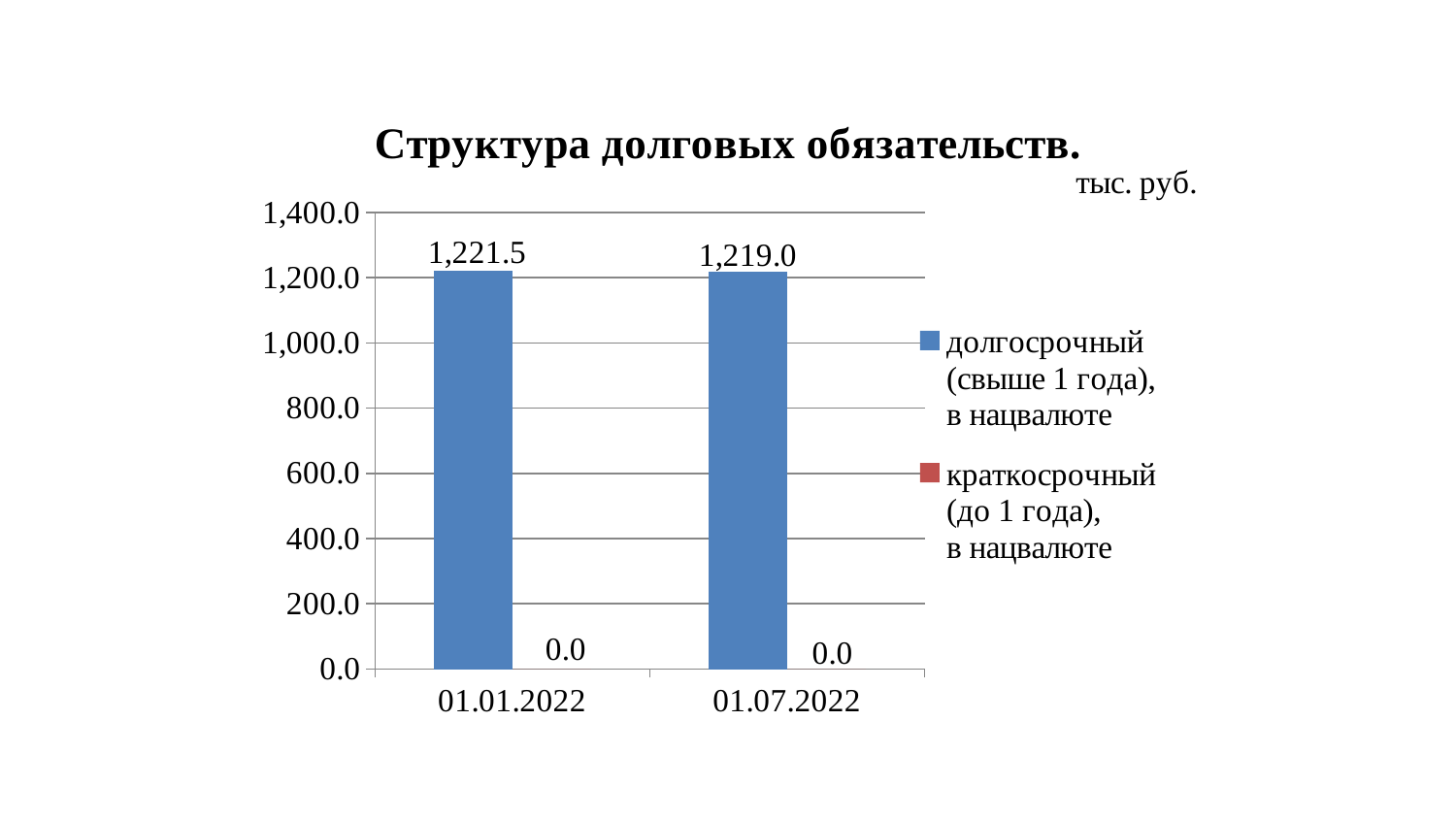
What is the difference between the долгосрочный values for 01.01.2022 and 01.07.2022? 2.5 How many series does the legend list? 2 What is the title of the chart? Структура долговых обязательств. What is the value of краткосрочный (до 1 года), в нацвалюте for 01.07.2022? 0.0 What is the value of долгосрочный (свыше 1 года), в нацвалюте for 01.01.2022? 1,221.5 What is the value of долгосрочный (свыше 1 года), в нацвалюте for 01.07.2022? 1,219.0 What unit is indicated for the chart values? тыс. руб. How many dates are shown on the x axis? 2 What is the value of краткосрочный (до 1 года), в нацвалюте for 01.01.2022? 0.0 Does the долгосрочный value rise or fall from 01.01.2022 to 01.07.2022? fall What kind of chart is shown on the slide? bar chart Is the долгосрочный value for 01.01.2022 greater or less than 1,200.0? greater